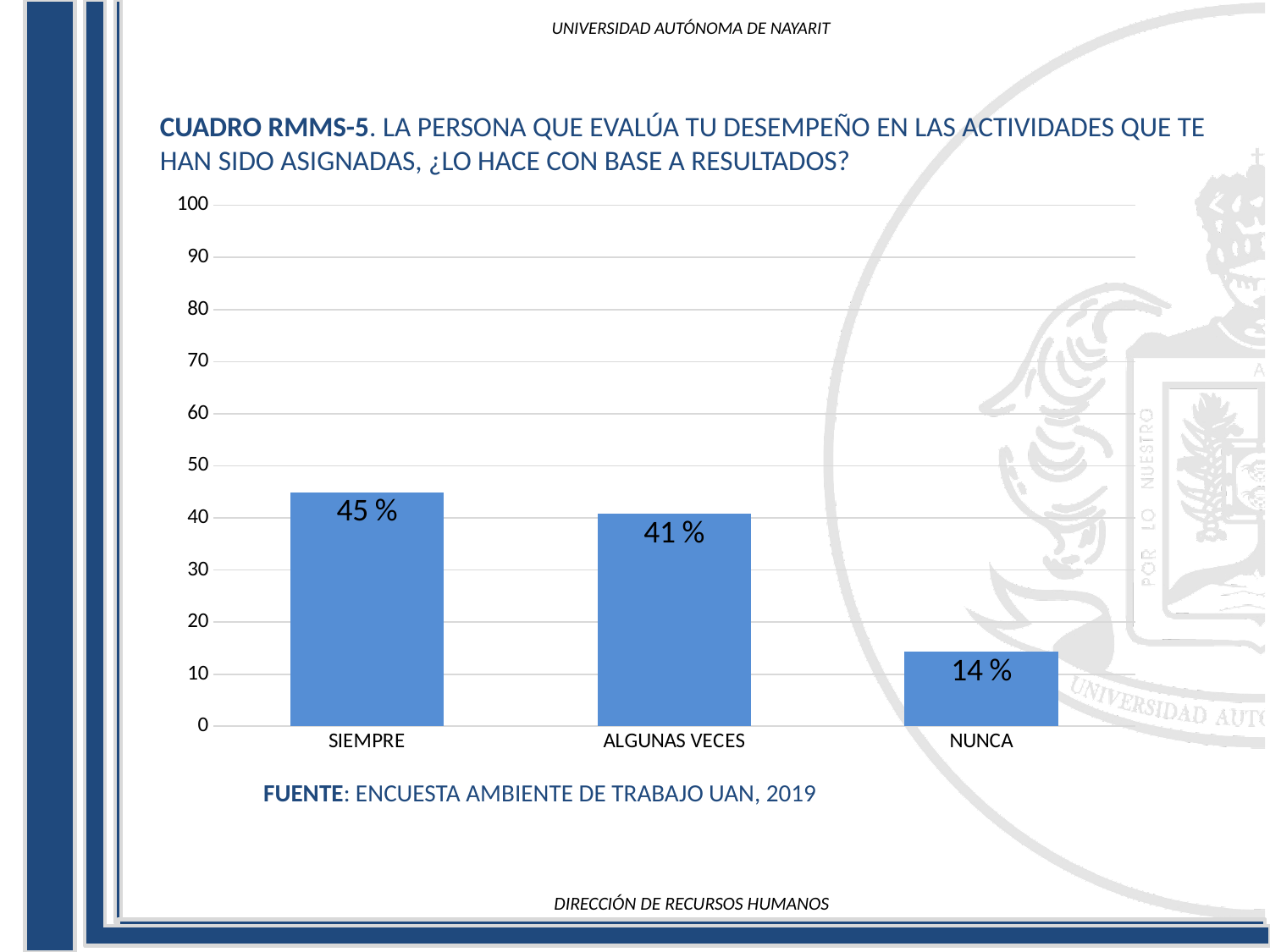
What source is cited below the chart? ENCUESTA AMBIENTE DE TRABAJO UAN, 2019 What is the difference between the values for SIEMPRE and NUNCA? 31 % What is the difference between the values for SIEMPRE and ALGUNAS VECES? 4 % Which is larger, the value for ALGUNAS VECES or the value for NUNCA? ALGUNAS VECES What is the value for ALGUNAS VECES? 41 % How many categories are shown on the x axis? 3 What is the value for NUNCA? 14 % What kind of chart is shown on the slide? bar chart Which category has the lowest value? NUNCA Is the value for NUNCA greater or less than 20? less What is the value for SIEMPRE? 45 % Which category has the highest value? SIEMPRE